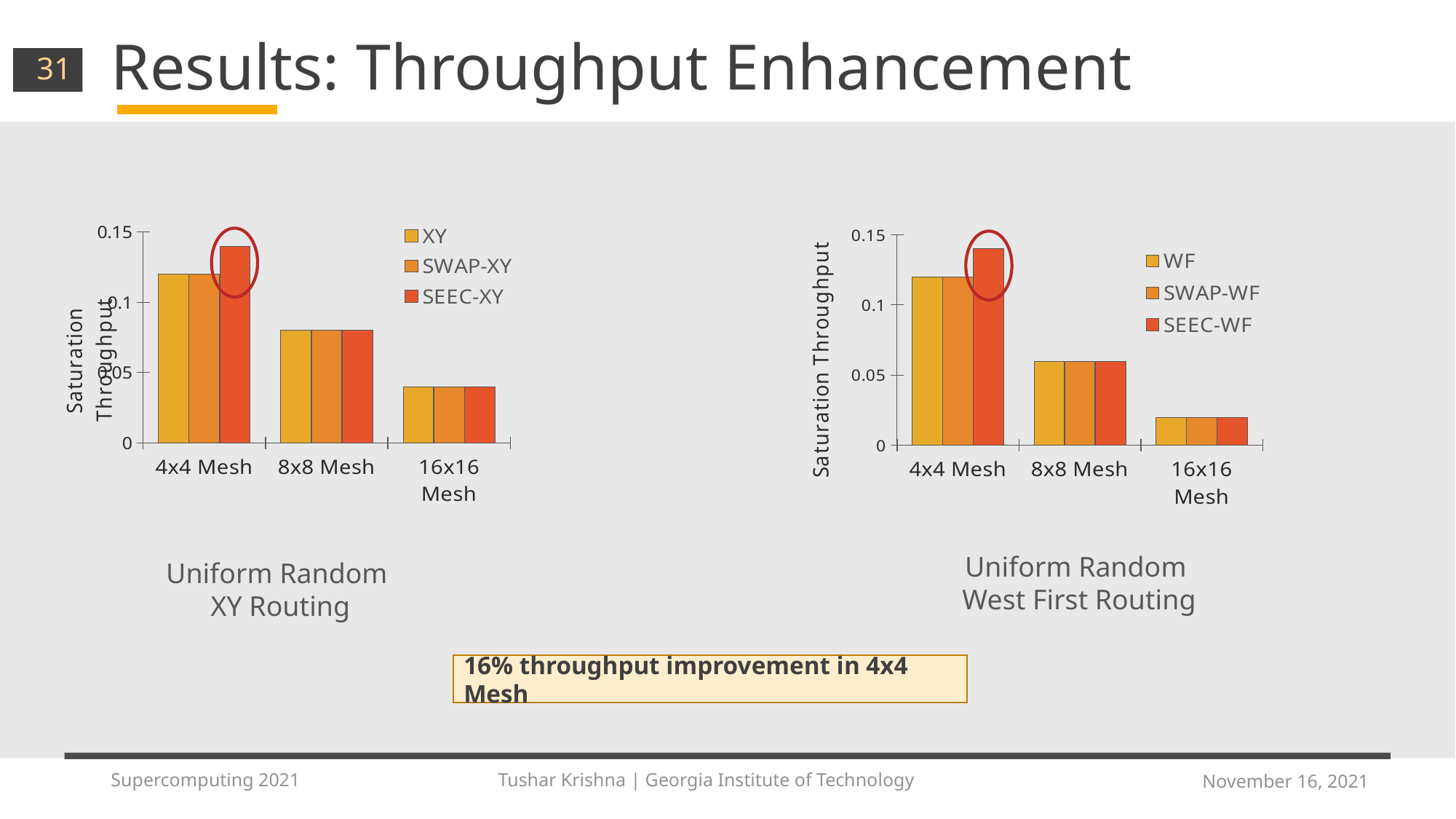
In the Uniform Random XY Routing chart, what kind of chart is shown? bar chart In the Uniform Random West First Routing chart, what are the three legend entries? WF, SWAP-WF, SEEC-WF In the Uniform Random West First Routing chart, how many mesh categories are shown on the x axis? 3 In the Uniform Random West First Routing chart, is the value for SEEC-WF on the 8x8 Mesh greater or less than 0.1? less In the Uniform Random XY Routing chart, is the value for XY on the 16x16 Mesh greater or less than 0.05? less In the Uniform Random West First Routing chart, which series has the highest value on the 4x4 Mesh? SEEC-WF In the Uniform Random West First Routing chart, is the value for WF on the 4x4 Mesh greater or less than 0.1? greater In the Uniform Random XY Routing chart, which is larger on the 4x4 Mesh: XY or SEEC-XY? SEEC-XY In the Uniform Random XY Routing chart, how many series does the legend list? 3 In the Uniform Random West First Routing chart, do the saturation throughput values rise or fall as the mesh size increases along the x axis? fall In the Uniform Random XY Routing chart, which mesh size has the lowest saturation throughput? 16x16 Mesh